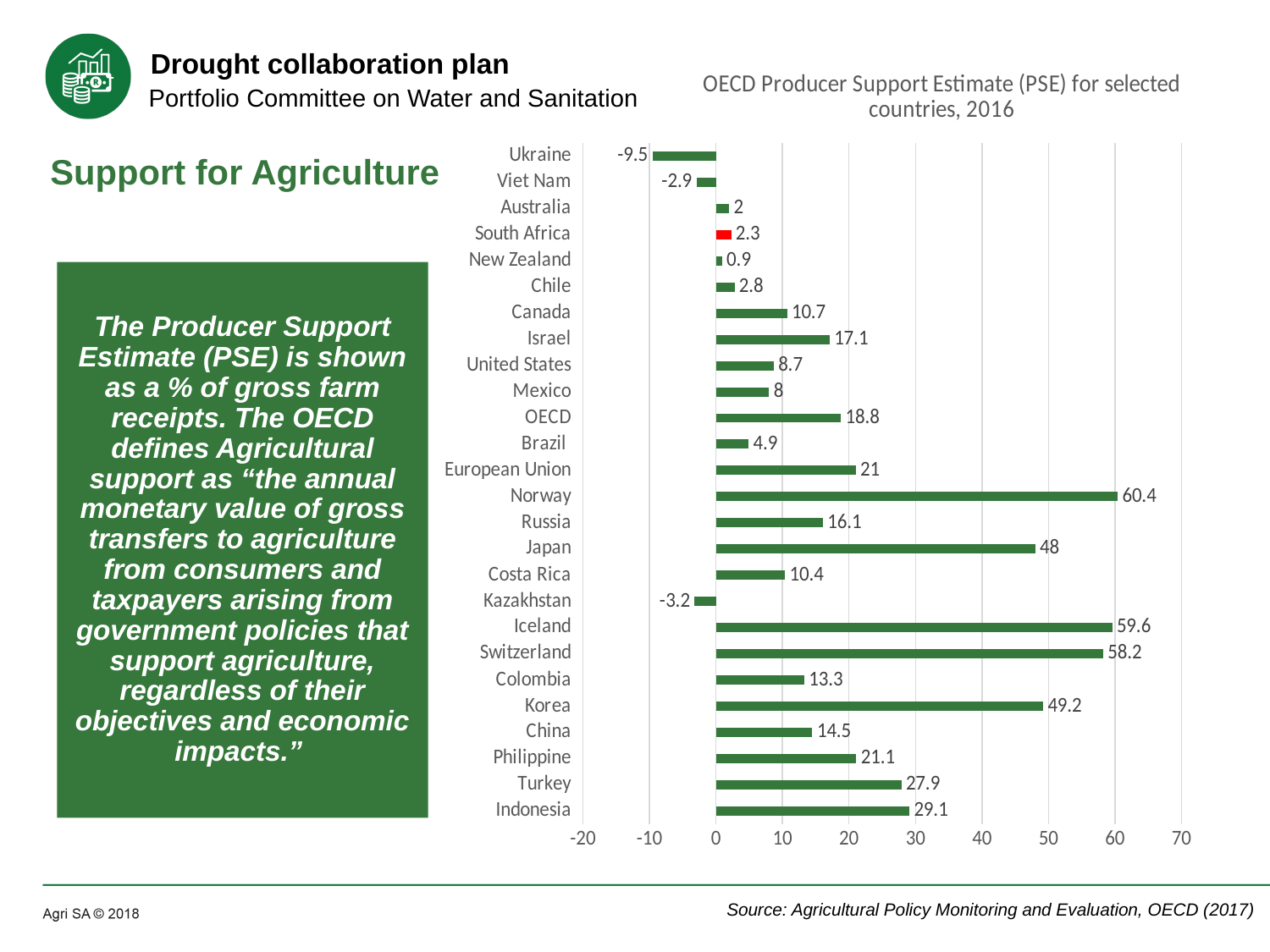
What is the PSE value for Kazakhstan? -3.2 What is the difference between the PSE values for Japan and Korea? 1.2 What is the PSE value for South Africa? 2.3 Which has a larger PSE value, Turkey or Indonesia? Indonesia Which has a larger PSE value, Iceland or Switzerland? Iceland Which country has the highest PSE value in the chart? Norway What is the title of the chart? OECD Producer Support Estimate (PSE) for selected countries, 2016 What is the PSE value for Norway? 60.4 What kind of chart is shown on the slide? Bar chart How many countries or regions are shown in the chart? 26 Which country's bar is coloured red in the chart? South Africa Which country has the lowest PSE value in the chart? Ukraine